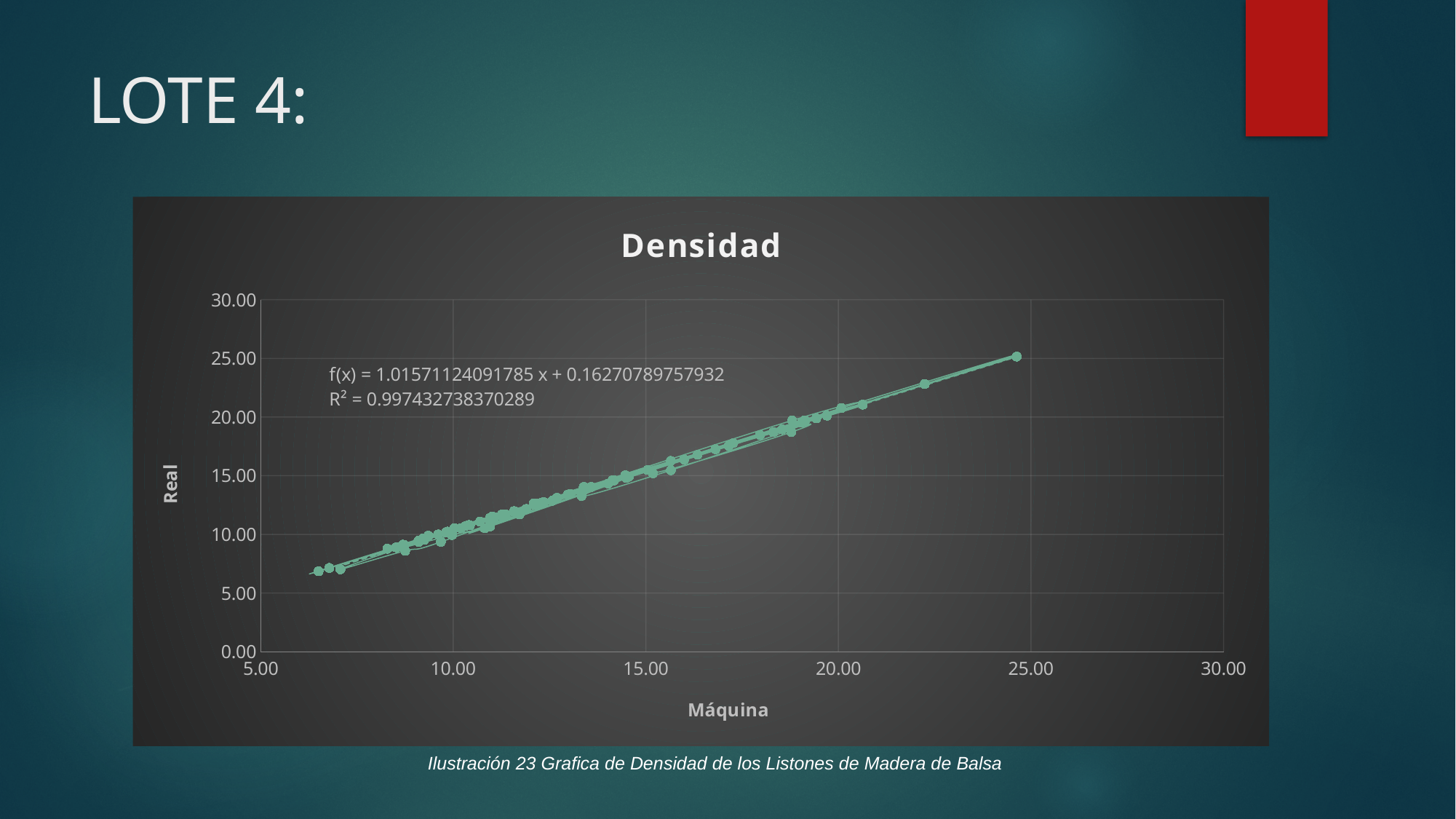
Is the Real value of the plotted point at Máquina about 22.2 greater or less than 20.00? greater What is the minimum value shown on the horizontal axis of the chart? 5.00 What is the maximum value shown on the vertical axis of the chart? 30.00 What kind of chart is shown on the slide? scatter chart What is the label of the horizontal axis of the chart? Máquina What is the title of the chart? Densidad Do the plotted values of Real rise or fall as Máquina increases along the x axis? rise